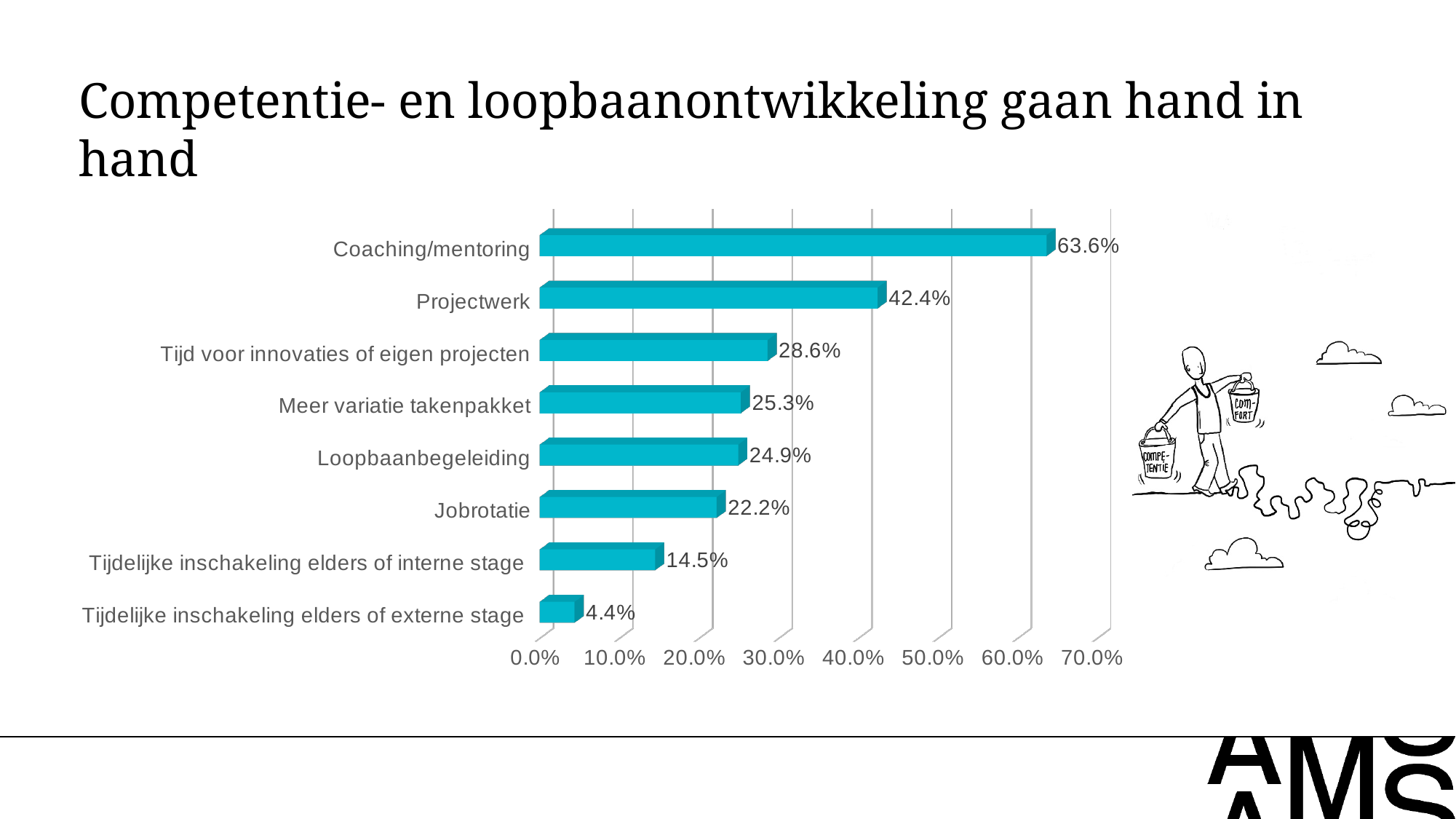
Which is larger: the value for Tijd voor innovaties of eigen projecten or the value for Meer variatie takenpakket? Tijd voor innovaties of eigen projecten What is the value for Jobrotatie? 22.2% What is the value for Coaching/mentoring? 63.6% What is the difference between the values for Coaching/mentoring and Projectwerk? 21.2% Which category has the highest value? Coaching/mentoring Which category has the lowest value? Tijdelijke inschakeling elders of externe stage What is the value for Projectwerk? 42.4% What is the value for Tijdelijke inschakeling elders of externe stage? 4.4% What is the title of the slide containing the chart? Competentie- en loopbaanontwikkeling gaan hand in hand What kind of chart is shown on the slide? Bar chart How many categories are shown in the chart? 8 Is the value for Tijdelijke inschakeling elders of interne stage greater or less than 20.0%? less